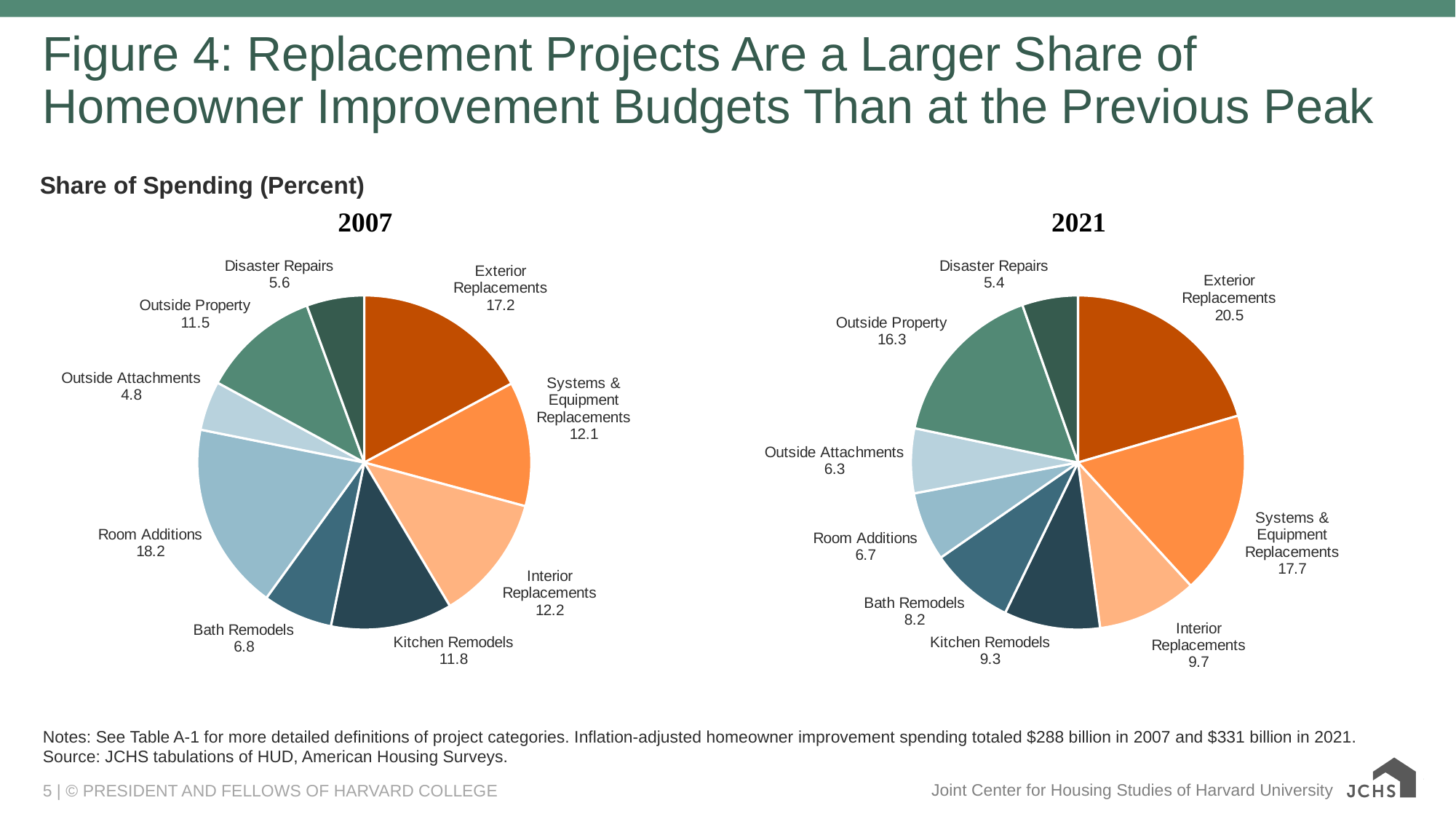
How many categories are shown in the 2007 pie chart? 9 By how many percentage points did the share for Room Additions fall from the 2007 chart to the 2021 chart? 11.5 In the 2021 pie chart, which category has the smallest share of spending? Disaster Repairs In the 2007 pie chart, which category has the smallest share of spending? Outside Attachments In the 2021 pie chart, what is the share of spending for Outside Property? 16.3 In the 2021 pie chart, which is larger: the share for Kitchen Remodels or the share for Bath Remodels? Kitchen Remodels In the 2007 pie chart, what is the share of spending for Room Additions? 18.2 By how many percentage points did the share for Exterior Replacements rise from the 2007 chart to the 2021 chart? 3.3 In the 2021 pie chart, what is the share of spending for Exterior Replacements? 20.5 What type of chart is used to show the 2021 share of spending? Pie chart In the 2007 pie chart, which category has the largest share of spending? Room Additions In the 2021 pie chart, which category has the largest share of spending? Exterior Replacements